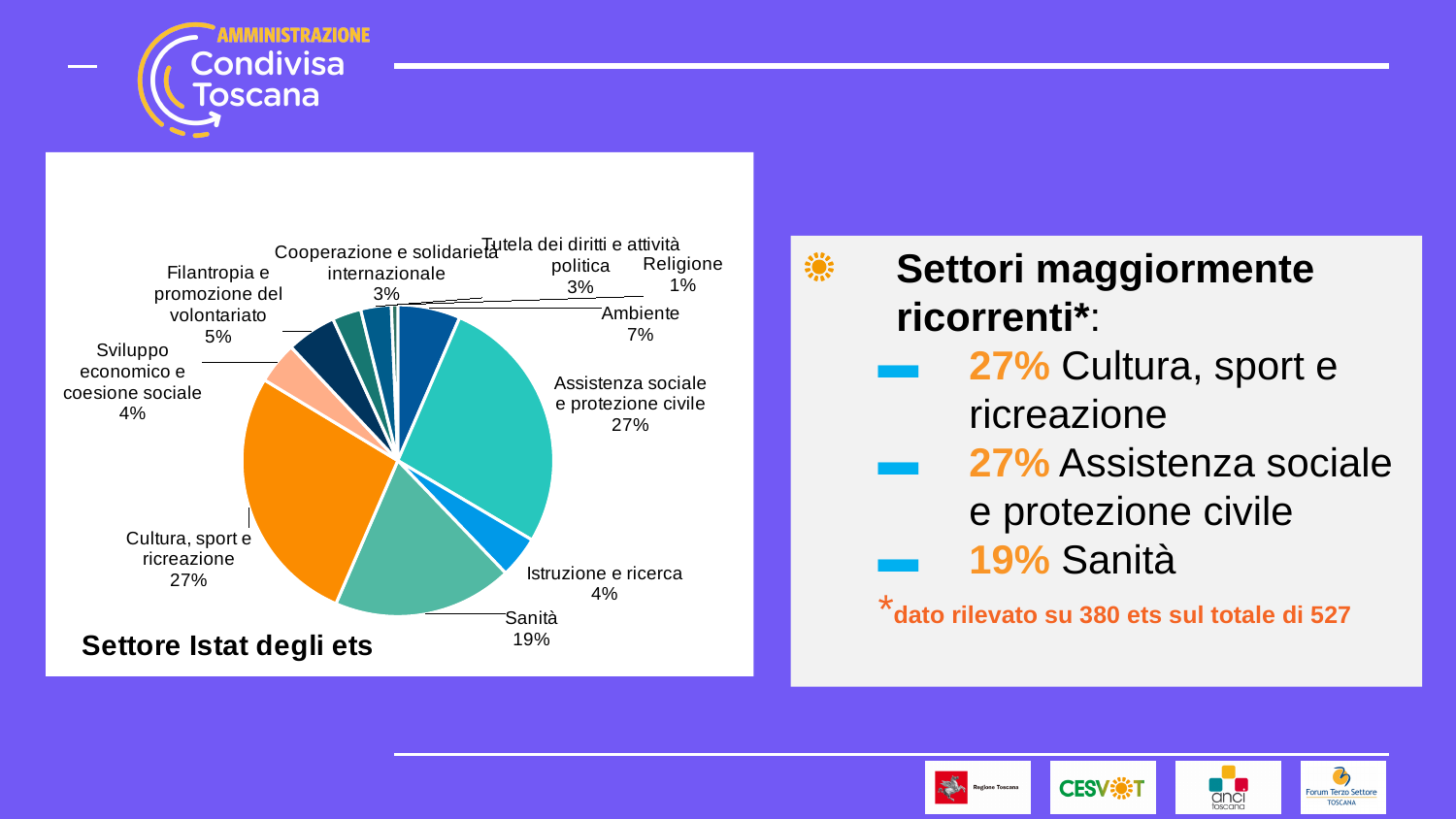
What kind of chart is shown on the slide? pie chart What is the value shown for Ambiente? 7% Which category has the smallest slice of the pie? Religione What share of the pie does Sanità represent? 19% What is the difference between the share for Sanità and the share for Ambiente? 12% What percentage is shown for Filantropia e promozione del volontariato? 5% What is the title of the chart? Settore Istat degli ets What percentage is shown for Cooperazione e solidarietà internazionale? 3% What is the difference between the share for Cultura, sport e ricreazione and the share for Sviluppo economico e coesione sociale? 23% Which is larger, the slice for Assistenza sociale e protezione civile or the slice for Sanità? Assistenza sociale e protezione civile What is the value for Istruzione e ricerca? 4% How many categories are shown in the pie chart? 10